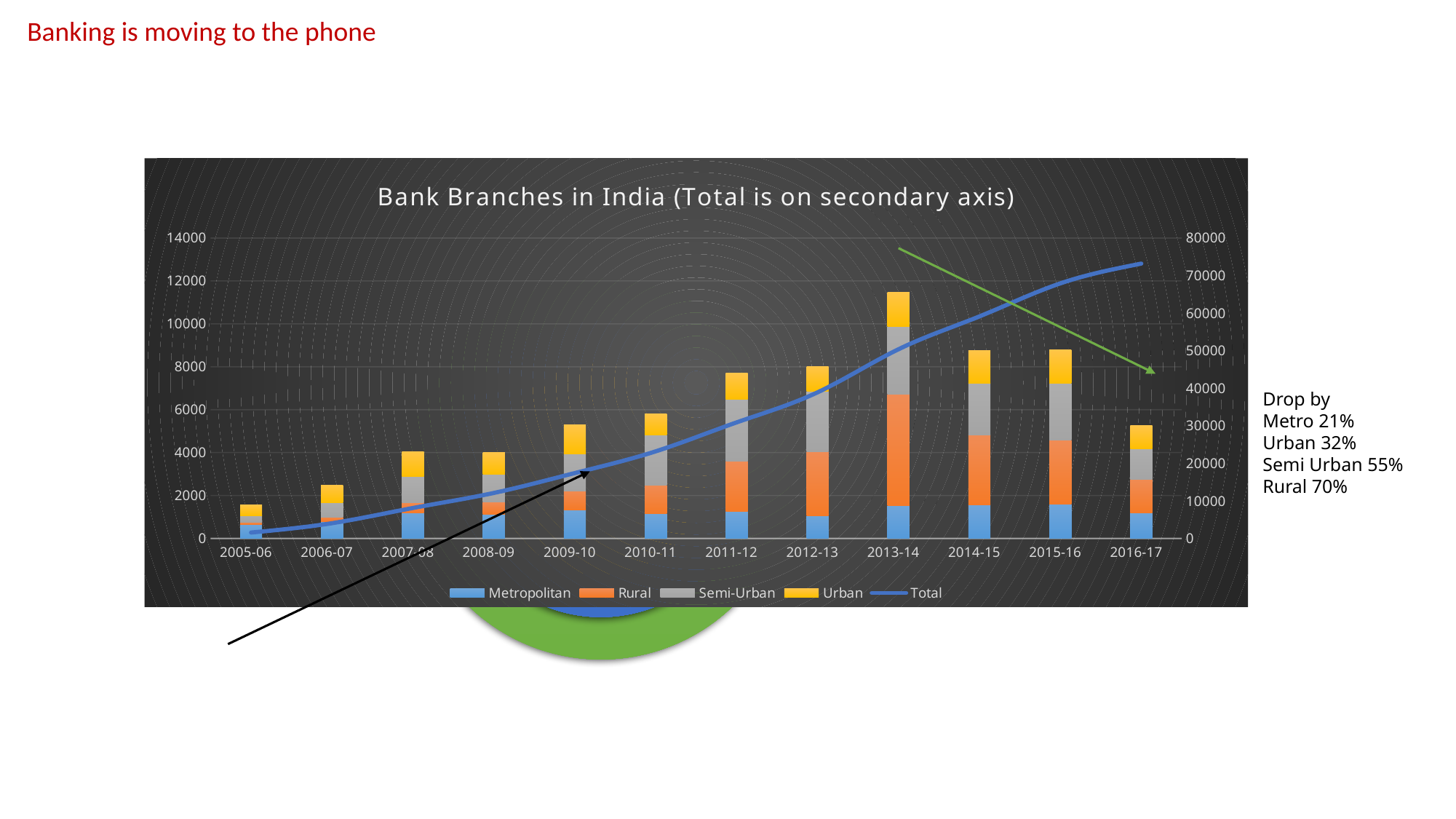
What is the title of the chart? Bank Branches in India (Total is on secondary axis) Which year has the tallest stacked bar? 2013-14 Which stacked bar is taller, 2012-13 or 2016-17? 2012-13 How many year categories are shown on the x axis? 12 Which series is plotted on the secondary axis? Total Which year has the shortest stacked bar? 2005-06 Does the Total line rise or fall from 2005-06 to 2016-17? Rises What kind of chart is shown on the slide? Stacked bar chart with a line Is the total height of the stacked bar for 2005-06 greater or less than 2000? less How many series does the legend list? 5 Is the total height of the stacked bar for 2013-14 greater or less than 10000? greater Is the Total line value for 2016-17 on the secondary axis greater or less than 70000? greater